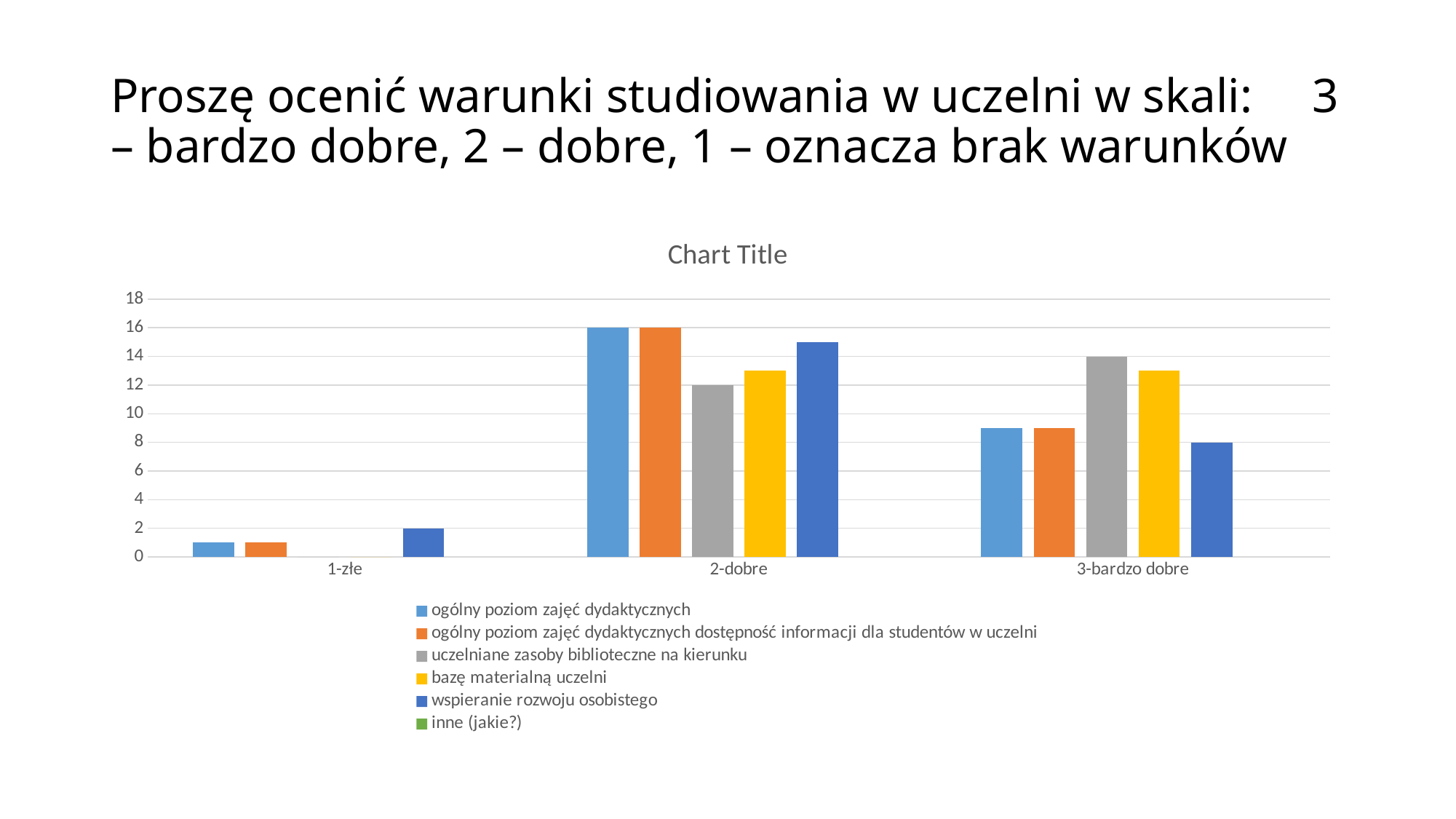
Is the value for 'ogólny poziom zajęć dydaktycznych' in the '3-bardzo dobre' category greater or less than 10? less How many categories are shown on the x axis? 3 What is the value for 'ogólny poziom zajęć dydaktycznych' in the '2-dobre' category? 16 What is the value for 'uczelniane zasoby biblioteczne na kierunku' in the '3-bardzo dobre' category? 14 What is the value for 'wspieranie rozwoju osobistego' in the '3-bardzo dobre' category? 8 What is the value for 'uczelniane zasoby biblioteczne na kierunku' in the '2-dobre' category? 12 What is the title shown above the chart? Chart Title How many series does the legend list? 6 In the '2-dobre' category, what is the difference between 'ogólny poziom zajęć dydaktycznych' and 'uczelniane zasoby biblioteczne na kierunku'? 4 What is the value for 'wspieranie rozwoju osobistego' in the '1-złe' category? 2 Which is larger for 'uczelniane zasoby biblioteczne na kierunku': the value in '2-dobre' or in '3-bardzo dobre'? 3-bardzo dobre What type of chart is shown on the slide? bar chart